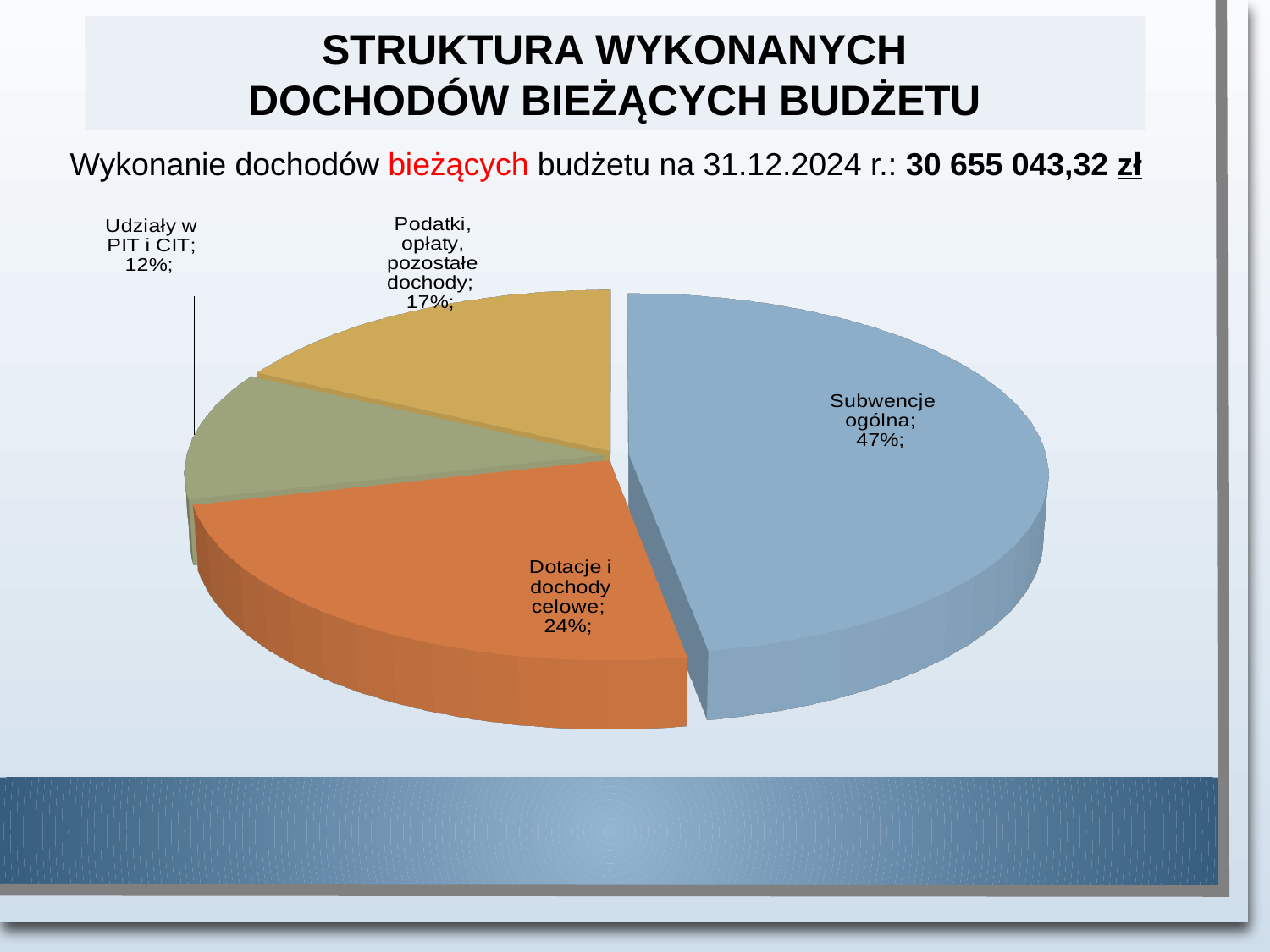
Which category has the largest share of the pie? Subwencje ogólna What share of the pie does Udziały w PIT i CIT represent? 12% Which category has the smallest share of the pie? Udziały w PIT i CIT What share of the pie does Dotacje i dochody celowe represent? 24% What kind of chart is shown on the slide? Pie chart How many categories are shown in the pie chart? 4 What is the difference in percentage points between Podatki, opłaty, pozostałe dochody and Udziały w PIT i CIT? 5 Which is larger: the share for Dotacje i dochody celowe or the share for Podatki, opłaty, pozostałe dochody? Dotacje i dochody celowe What is the difference in percentage points between Subwencje ogólna and Dotacje i dochody celowe? 23 What share of the pie does Podatki, opłaty, pozostałe dochody represent? 17% What total amount of current budget revenue as of 31.12.2024 is stated on the slide? 30 655 043,32 zł